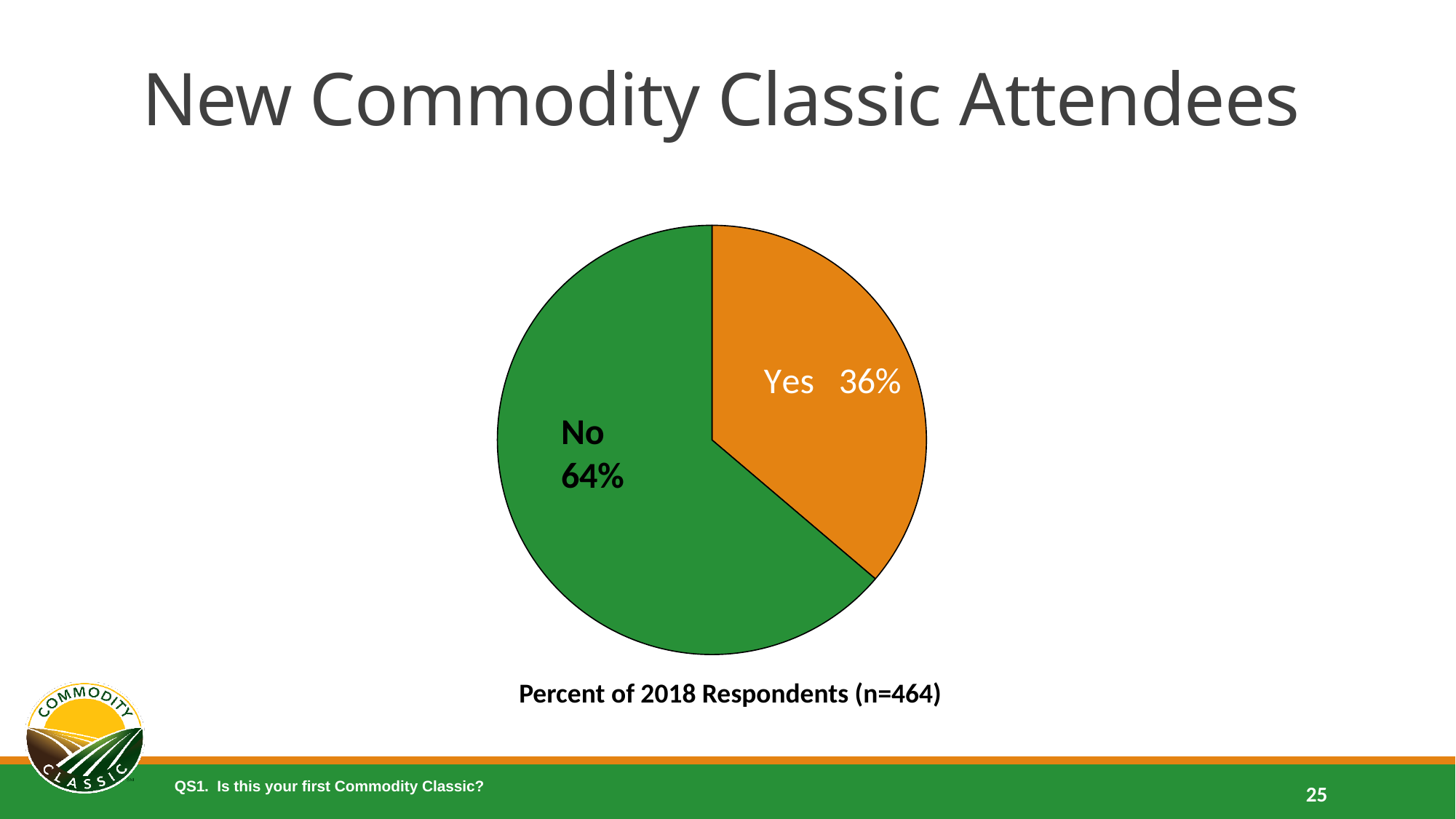
What percentage of respondents answered "No"? 64% What is the title of the slide? New Commodity Classic Attendees Which slice of the pie is the smallest? Yes How many respondents (n) does the chart caption say were surveyed in 2018? 464 Which is larger, the "Yes" slice or the "No" slice? No What kind of chart is shown on the slide? Pie chart What percentage of respondents answered "Yes"? 36% What is the difference in percentage points between the "No" and "Yes" slices? 28 What share of the pie does the "Yes" slice represent? 36% Which slice of the pie is the largest? No How many slices does the pie chart have? 2